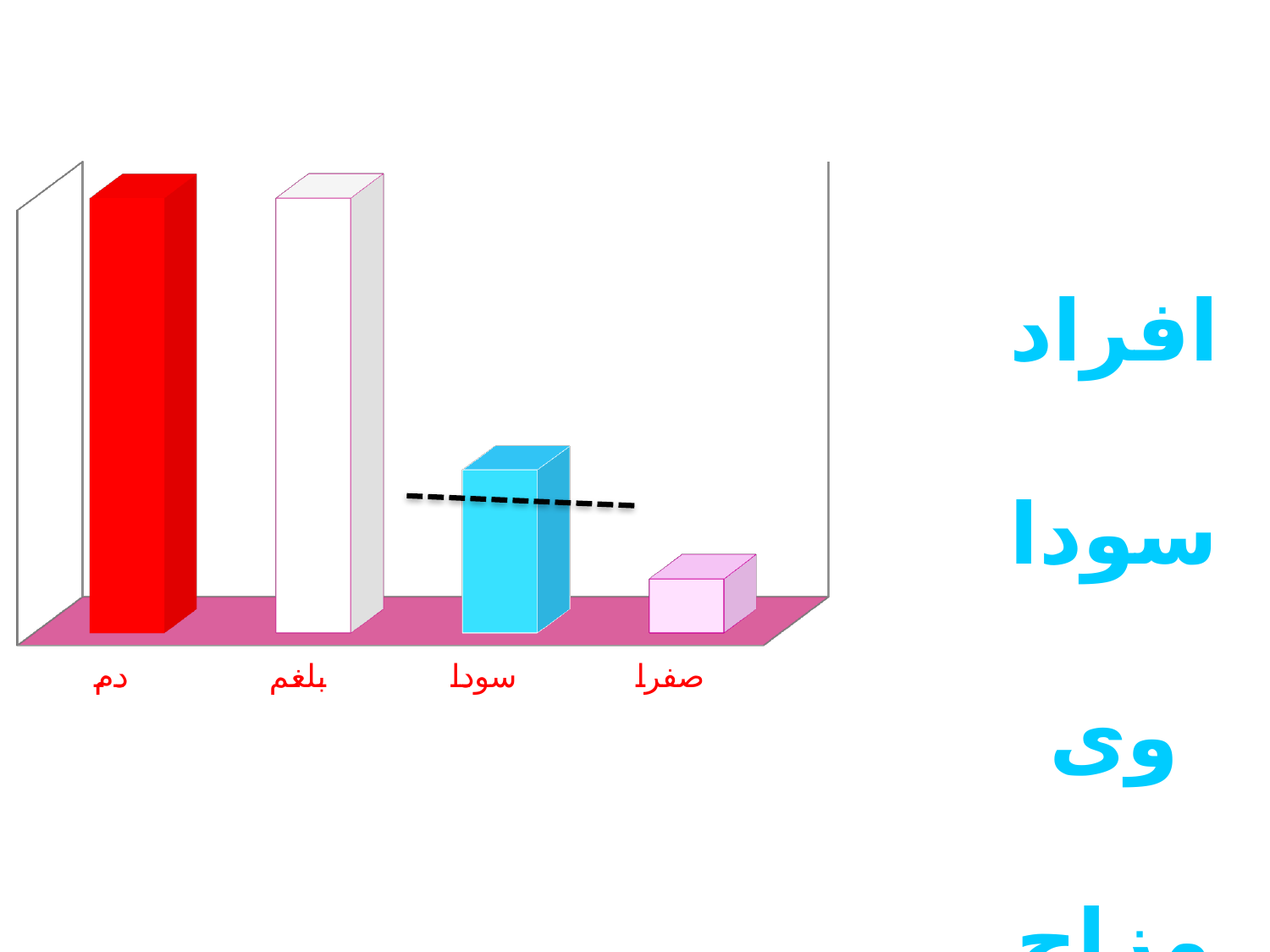
Which is larger, the bar for سودا or the bar for صفرا? سودا Which category has the lowest bar in the chart? صفرا Do the bar heights generally rise or fall moving from دم on the left to صفرا on the right? fall Which is larger, the bar for بلغم or the bar for سودا? بلغم What colour is the bar for دم? red How many categories are shown on the x axis of the chart? 4 Which is larger, the bar for دم or the bar for سودا? دم What kind of chart is shown on the slide? bar chart What colour is the bar for سودا? light blue